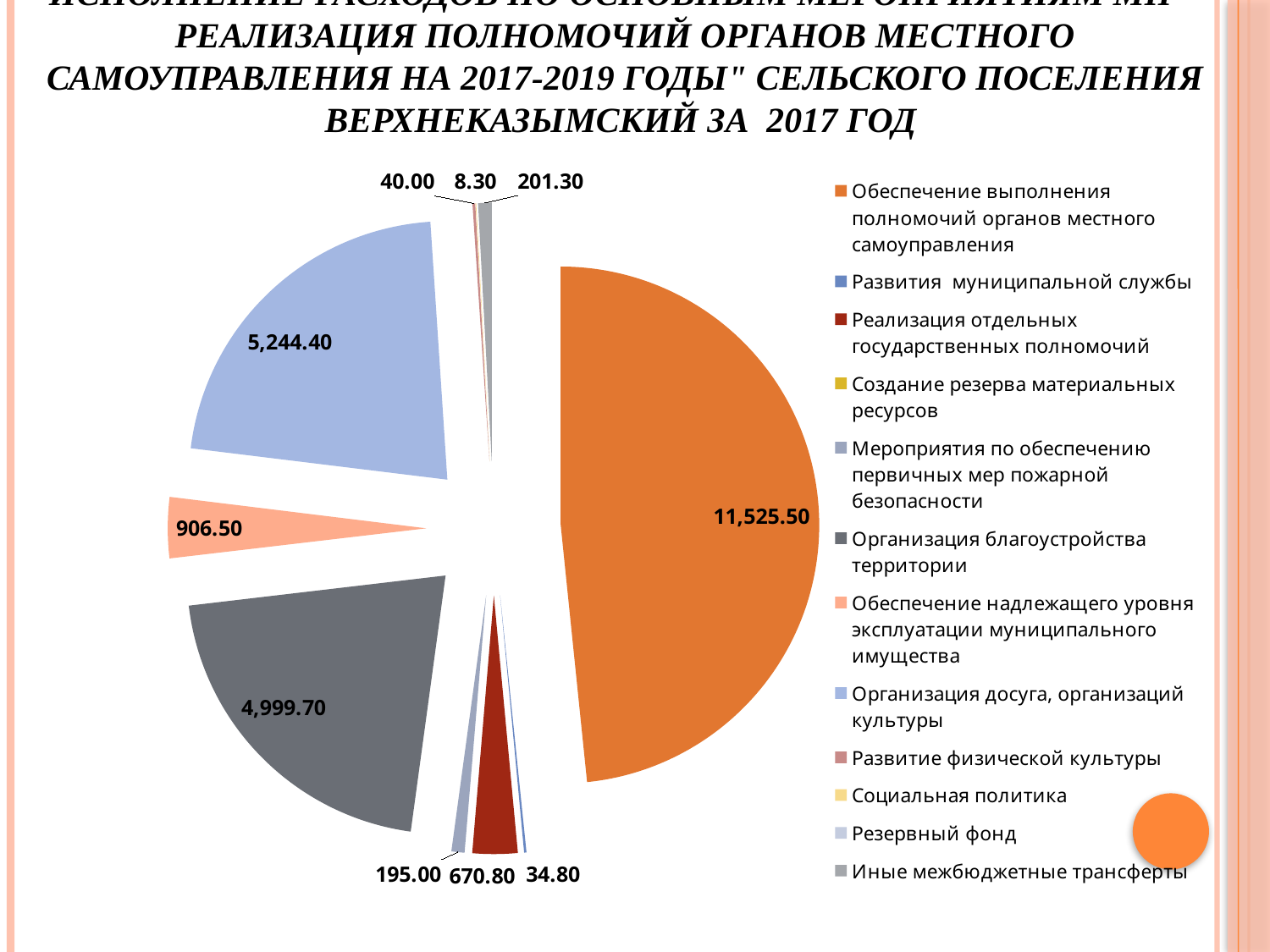
Which is larger: "Организация досуга, организаций культуры" or "Организация благоустройства территории"? Организация досуга, организаций культуры What is the value shown for "Реализация отдельных государственных полномочий"? 670.80 By how much does "Обеспечение выполнения полномочий органов местного самоуправления" exceed "Организация досуга, организаций культуры"? 6,281.10 What colour is the largest slice of the pie chart? Orange What is the value shown for "Организация досуга, организаций культуры"? 5,244.40 How many entries does the legend of the pie chart list? 12 What is the difference between the values for "Организация досуга, организаций культуры" and "Организация благоустройства территории"? 244.70 What is the value shown for "Обеспечение выполнения полномочий органов местного самоуправления"? 11,525.50 What is the value shown for "Обеспечение надлежащего уровня эксплуатации муниципального имущества"? 906.50 Which category has the largest slice of the pie? Обеспечение выполнения полномочий органов местного самоуправления What kind of chart is shown on the slide? Pie chart What is the value shown for "Организация благоустройства территории"? 4,999.70